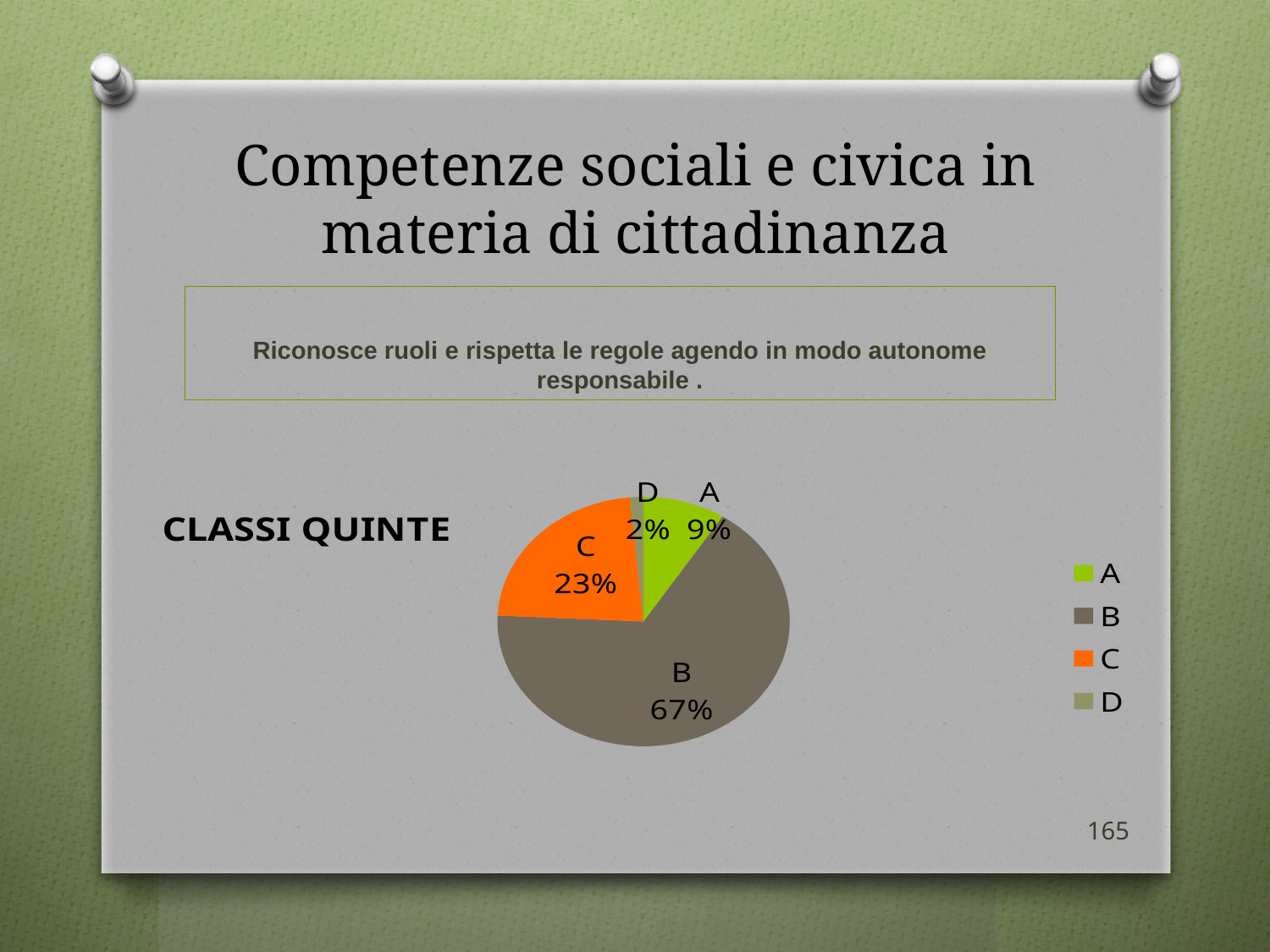
What percentage of the pie does category B represent? 67% What percentage of the pie does category A represent? 9% What is the difference in percentage points between category B and category C? 44 What label appears to the left of the pie chart? CLASSI QUINTE What kind of chart is shown on the slide? pie chart What percentage of the pie does category D represent? 2% Which is larger, the slice for A or the slice for C? C What percentage of the pie does category C represent? 23% How many entries does the legend list? 4 Which category has the largest slice of the pie? B Which category has the smallest slice of the pie? D How many categories are shown in the pie chart? 4